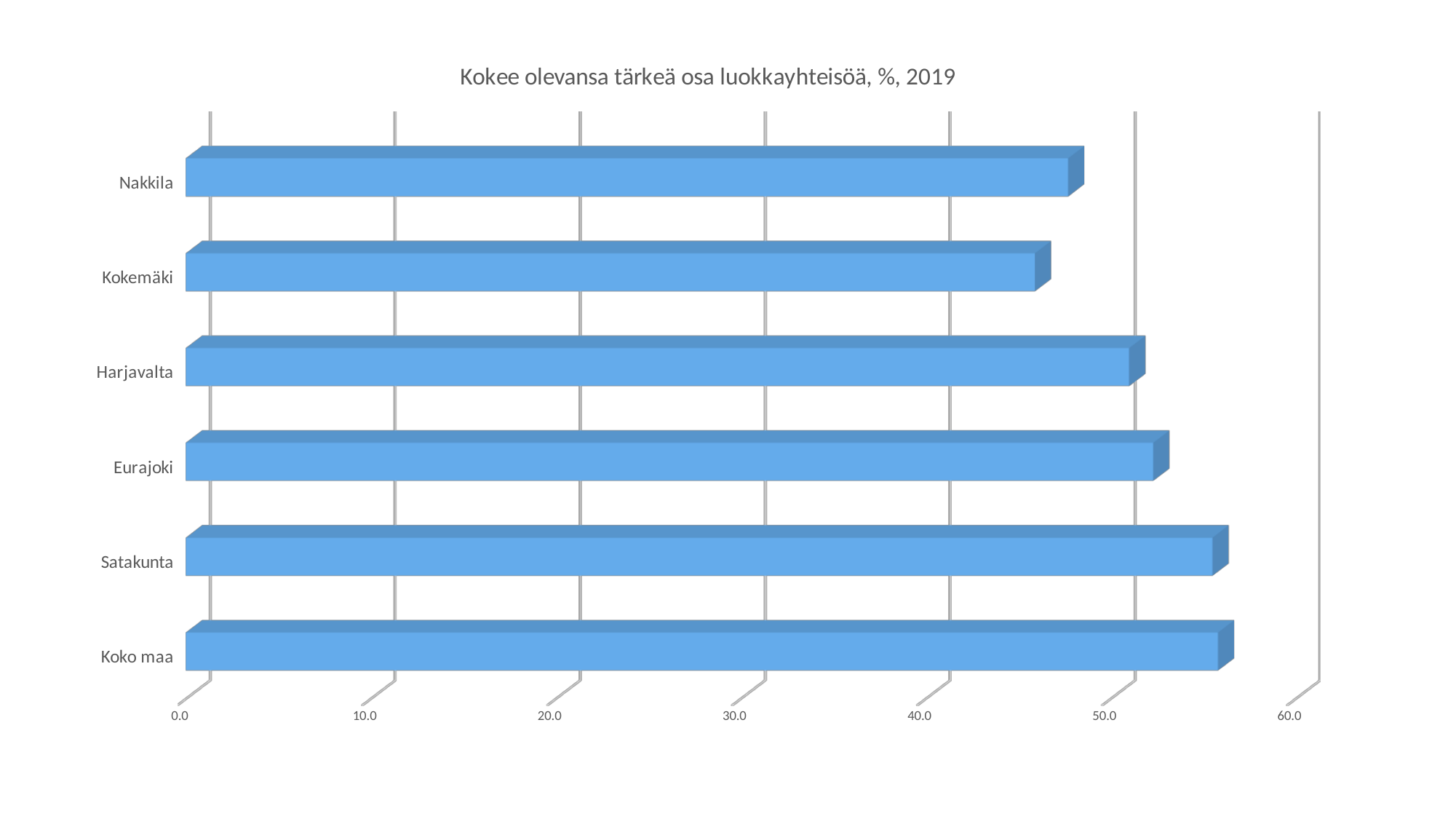
Which has the larger value, Satakunta or Kokemäki? Satakunta Which has the larger value, Harjavalta or Nakkila? Harjavalta What is the title of the chart? Kokee olevansa tärkeä osa luokkayhteisöä, %, 2019 Is the value for Kokemäki greater or less than 40? greater Which category has the lowest value in the chart? Kokemäki Is the value for Koko maa greater or less than 60? less How many categories are plotted in the chart? 6 What kind of chart is shown on the slide? bar chart Is the value for Nakkila greater or less than 50? less Which has the larger value, Eurajoki or Nakkila? Eurajoki